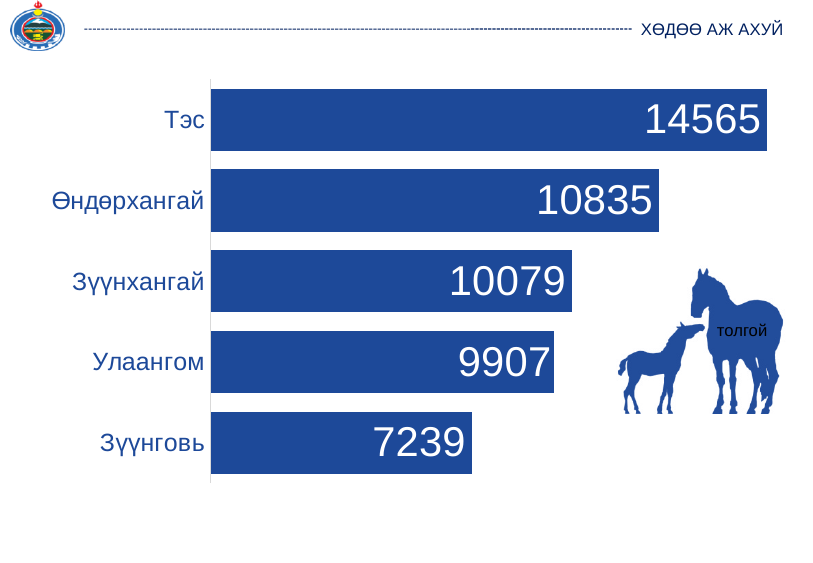
What kind of chart is shown on the slide? bar chart What is the difference between the values for Зүүнхангай and Улаангом? 172 What is the value for Өндөрхангай? 10835 What is the value for Тэс? 14565 Which category has the highest value? Тэс Which category has the lowest value? Зүүнговь What is the value for Зүүнговь? 7239 How many categories are shown in the chart? 5 What colour are the bars in the chart? blue What is the value for Улаангом? 9907 What is the difference between the values for Тэс and Өндөрхангай? 3730 Which is larger, the value for Зүүнхангай or the value for Зүүнговь? Зүүнхангай